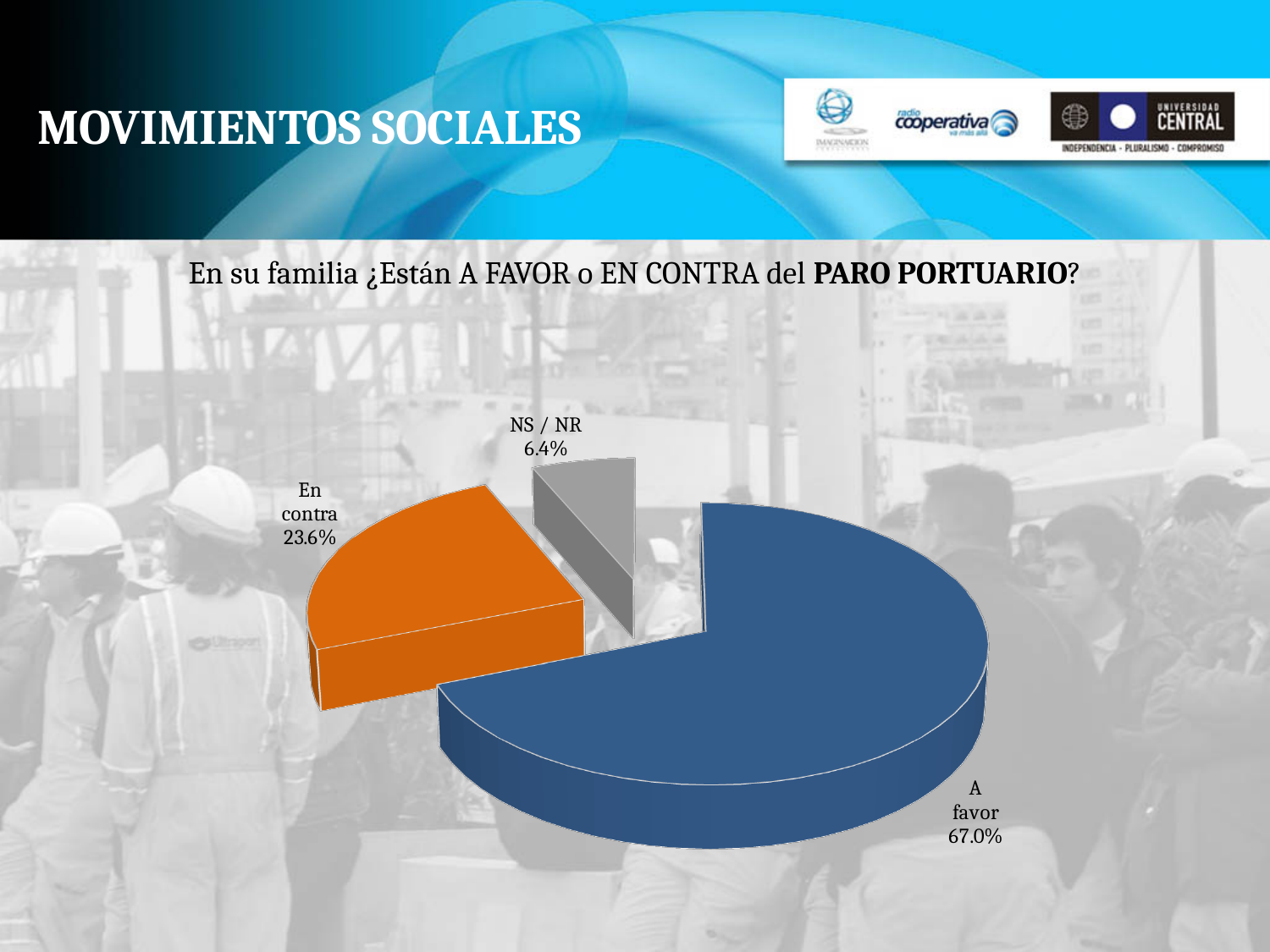
Which category has the smallest share of the pie? NS / NR Which is larger, the share for "En contra" or the share for "NS / NR"? En contra How many categories does the pie chart show? 3 What percentage of respondents answered "NS / NR"? 6.4% What percentage of respondents answered "A favor"? 67.0% What is the difference in percentage points between "A favor" and "En contra"? 43.4 Which category has the largest share of the pie? A favor What question does the chart answer, according to the text above it? En su familia ¿Están A FAVOR o EN CONTRA del PARO PORTUARIO? What is the difference in percentage points between "En contra" and "NS / NR"? 17.2 What kind of chart is shown on the slide? Pie chart What colour is the "A favor" slice? Blue What percentage of respondents answered "En contra"? 23.6%